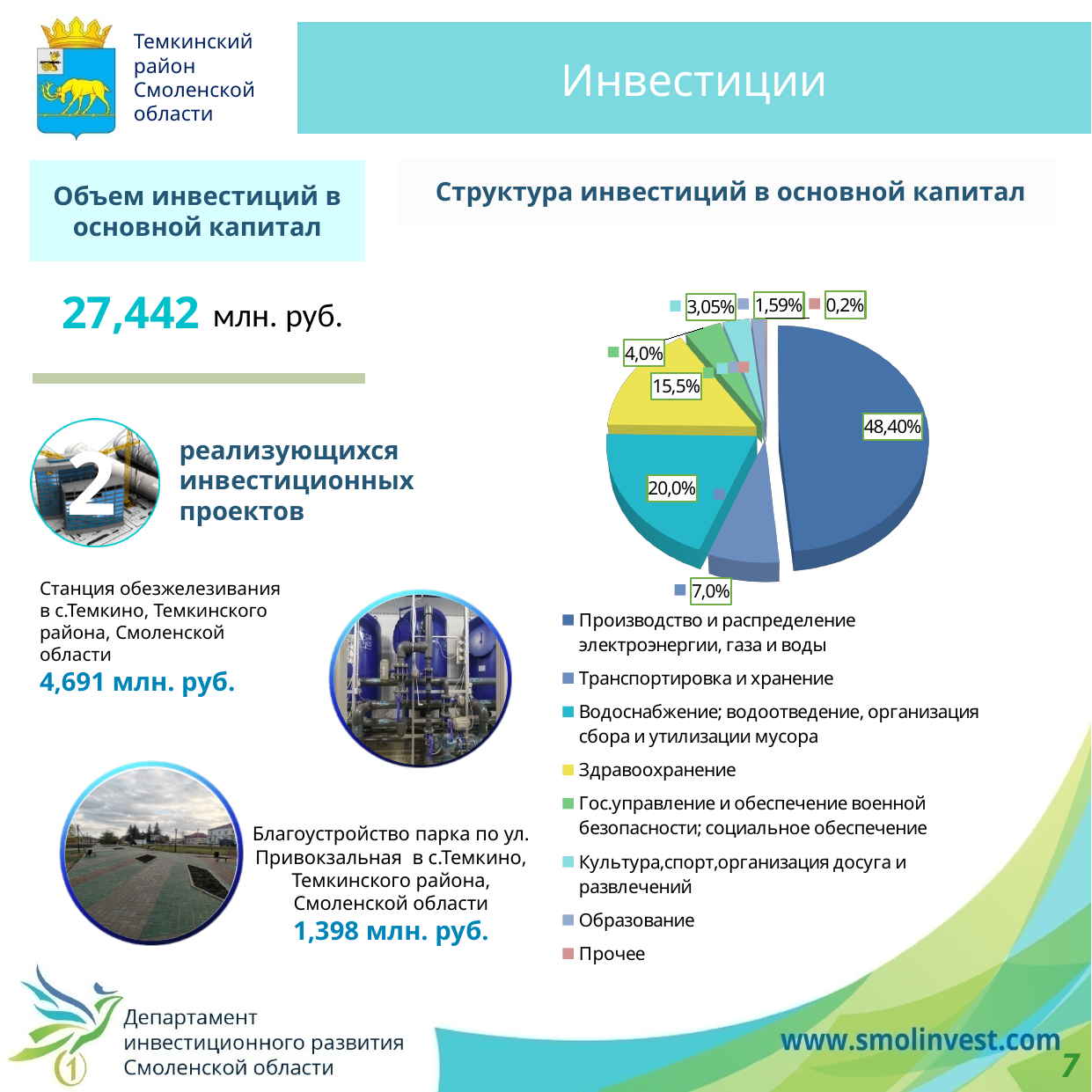
What share of the pie chart does "Транспортировка и хранение" have? 7,0% What share of the pie chart does "Образование" have? 1,59% Which category has the largest slice in the pie chart? Производство и распределение электроэнергии, газа и воды What is the difference between the shares of "Водоснабжение; водоотведение, организация сбора и утилизации мусора" (20,0%) and "Транспортировка и хранение" (7,0%) in the pie chart? 13,0% What is the title of the pie chart? Структура инвестиций в основной капитал What share of the pie chart does "Прочее" have? 0,2% What share of the pie chart does "Здравоохранение" have? 15,5% Which category has the smallest slice in the pie chart? Прочее How many categories does the pie chart's legend list? 8 Which is larger in the pie chart: "Водоснабжение; водоотведение, организация сбора и утилизации мусора" or "Здравоохранение"? Водоснабжение; водоотведение, организация сбора и утилизации мусора What kind of chart is shown under the title "Структура инвестиций в основной капитал"? pie chart What share of the pie chart does "Производство и распределение электроэнергии, газа и воды" have? 48,40%